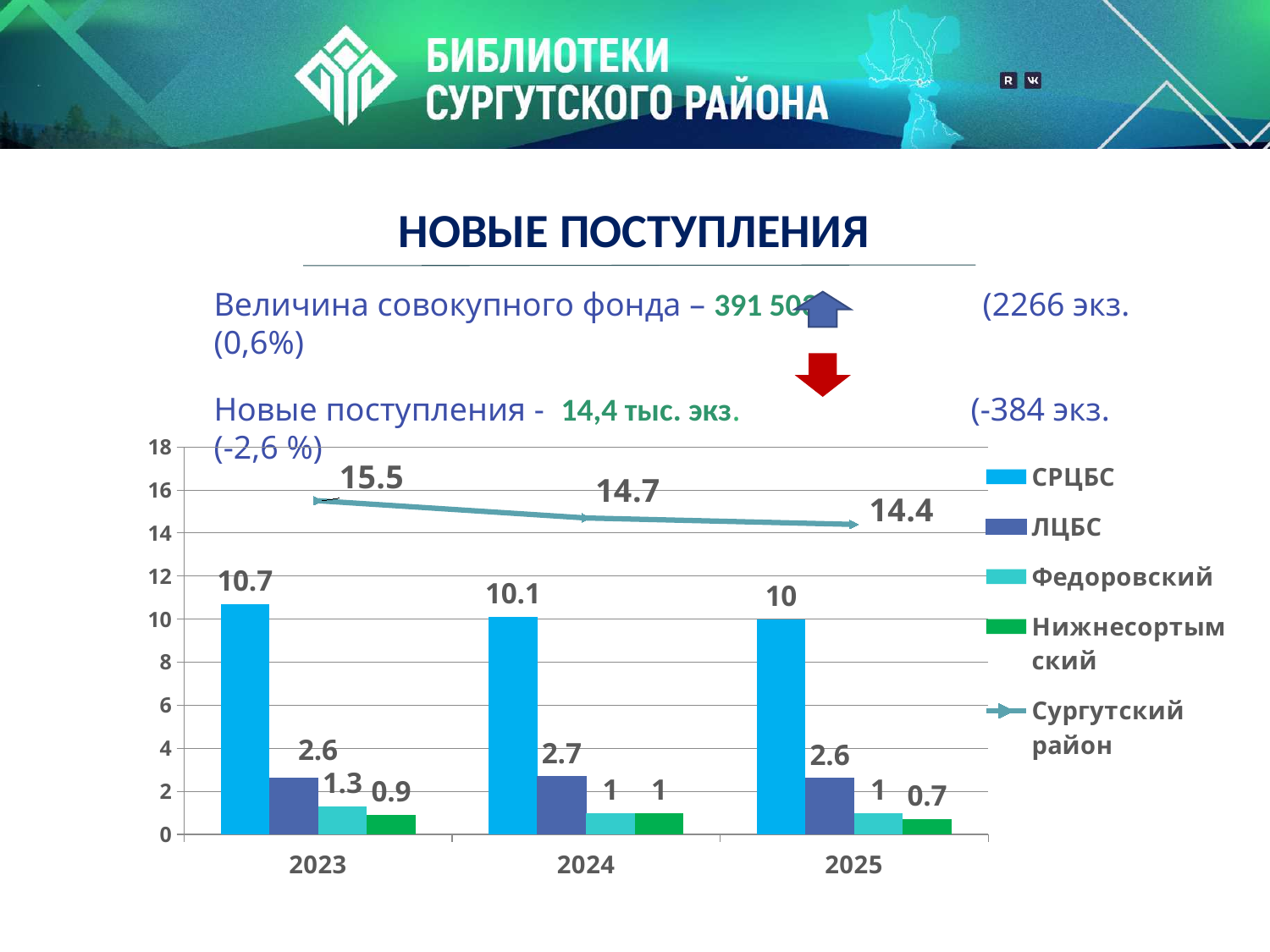
What is the value of the Сургутский район line in 2025? 14.4 Which series has the lowest value in 2023? Нижнесортымский How many series does the legend list? 5 What is the value for СРЦБС in 2023? 10.7 How many years are shown on the x axis? 3 Which year has the highest value for the Сургутский район line? 2023 Does the Сургутский район line rise or fall from 2023 to 2025? fall What is the difference between the Сургутский район values in 2023 and 2025? 1.1 Which series is shown as a line rather than bars? Сургутский район What is the value for ЛЦБС in 2024? 2.7 What is the value for Нижнесортымский in 2025? 0.7 Which is larger: the value for Федоровский in 2023 or in 2024? 2023